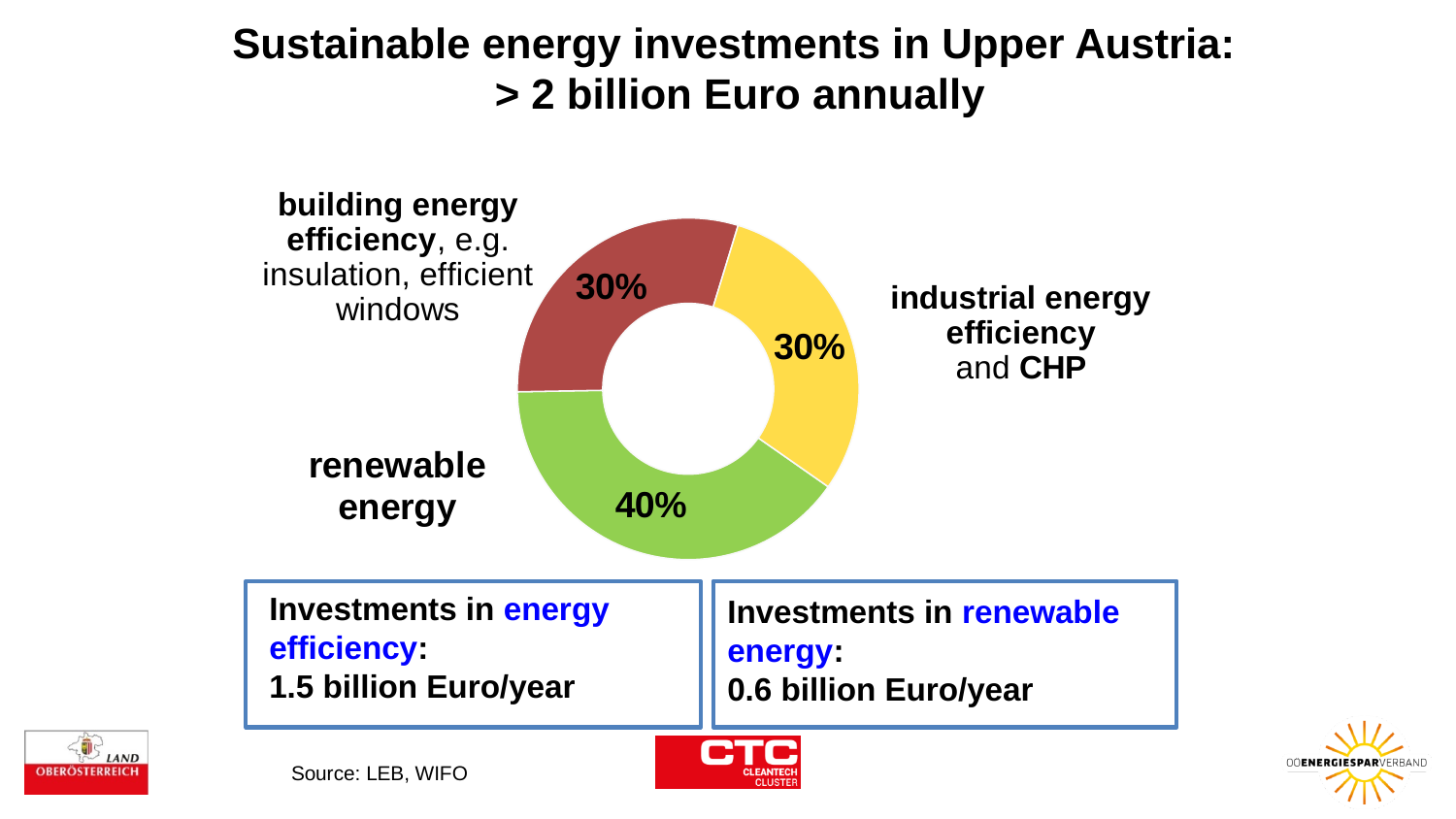
What kind of chart is shown on the slide? pie chart (doughnut) What share of sustainable energy investments goes to renewable energy? 40% What share of sustainable energy investments goes to industrial energy efficiency and CHP? 30% Which is larger: the share for renewable energy or the share for industrial energy efficiency and CHP? renewable energy What share of sustainable energy investments goes to building energy efficiency? 30% What is the combined share of the two energy efficiency categories (building and industrial)? 60% What is the difference in percentage points between the renewable energy share and the building energy efficiency share? 10 percentage points How many categories are shown in the pie chart? 3 Which category has the largest share of the pie? renewable energy What colour is the building energy efficiency slice? red What colour is the renewable energy slice? green